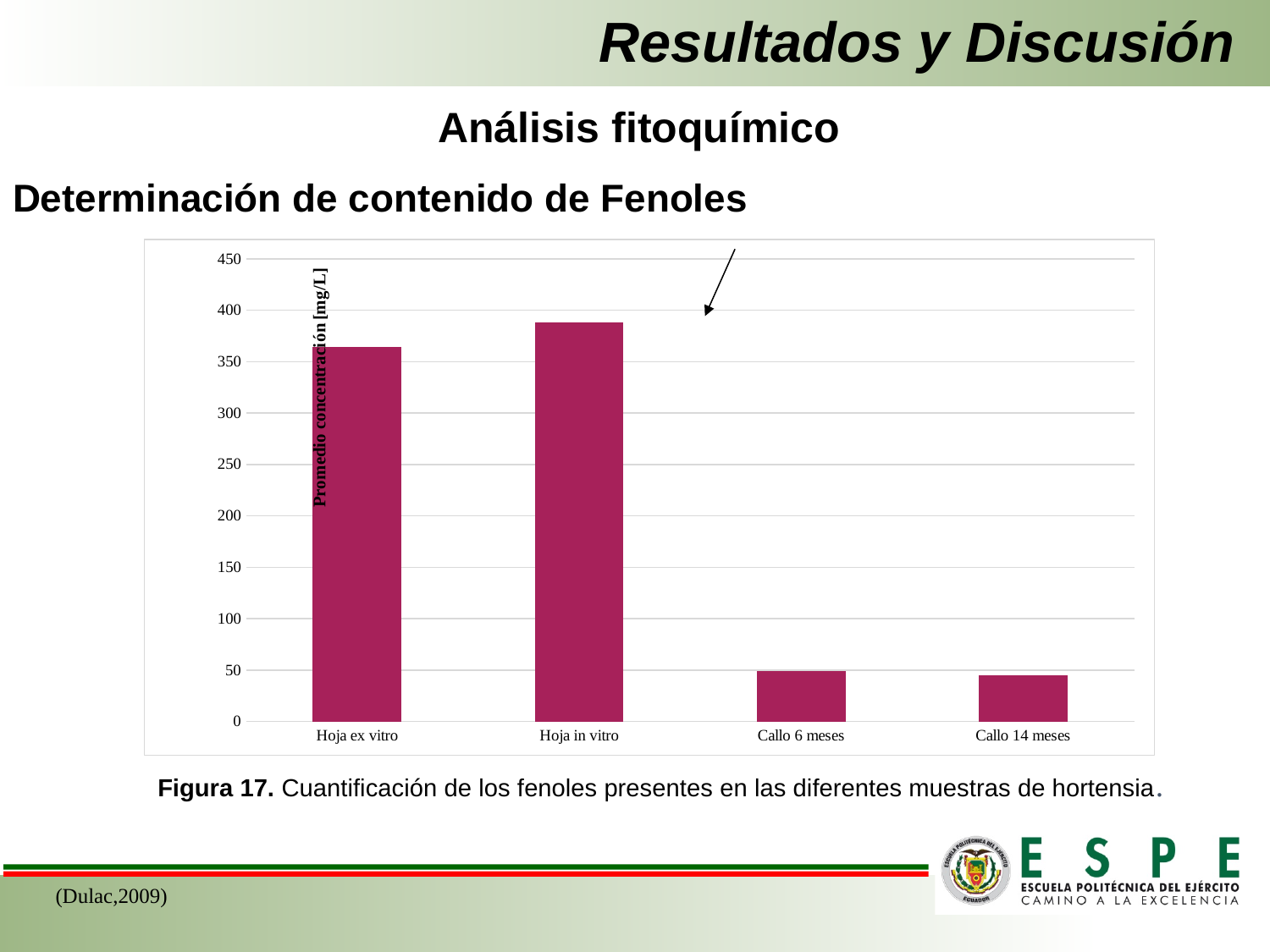
What is the label of the vertical axis of the chart? Promedio concentración [mg/L] What kind of chart is shown on the slide? Bar chart Is the value for Hoja ex vitro greater or less than 350? greater Is the value for Hoja in vitro greater or less than 300? greater What is the figure number given in the caption below the chart? Figura 17 Is the value for Hoja in vitro greater or less than 400? less Which is larger, the value for Hoja ex vitro or the value for Callo 6 meses? Hoja ex vitro How many categories are shown on the x axis of the chart? 4 Which is larger, the value for Hoja ex vitro or the value for Hoja in vitro? Hoja in vitro Which category has the highest value in the chart? Hoja in vitro